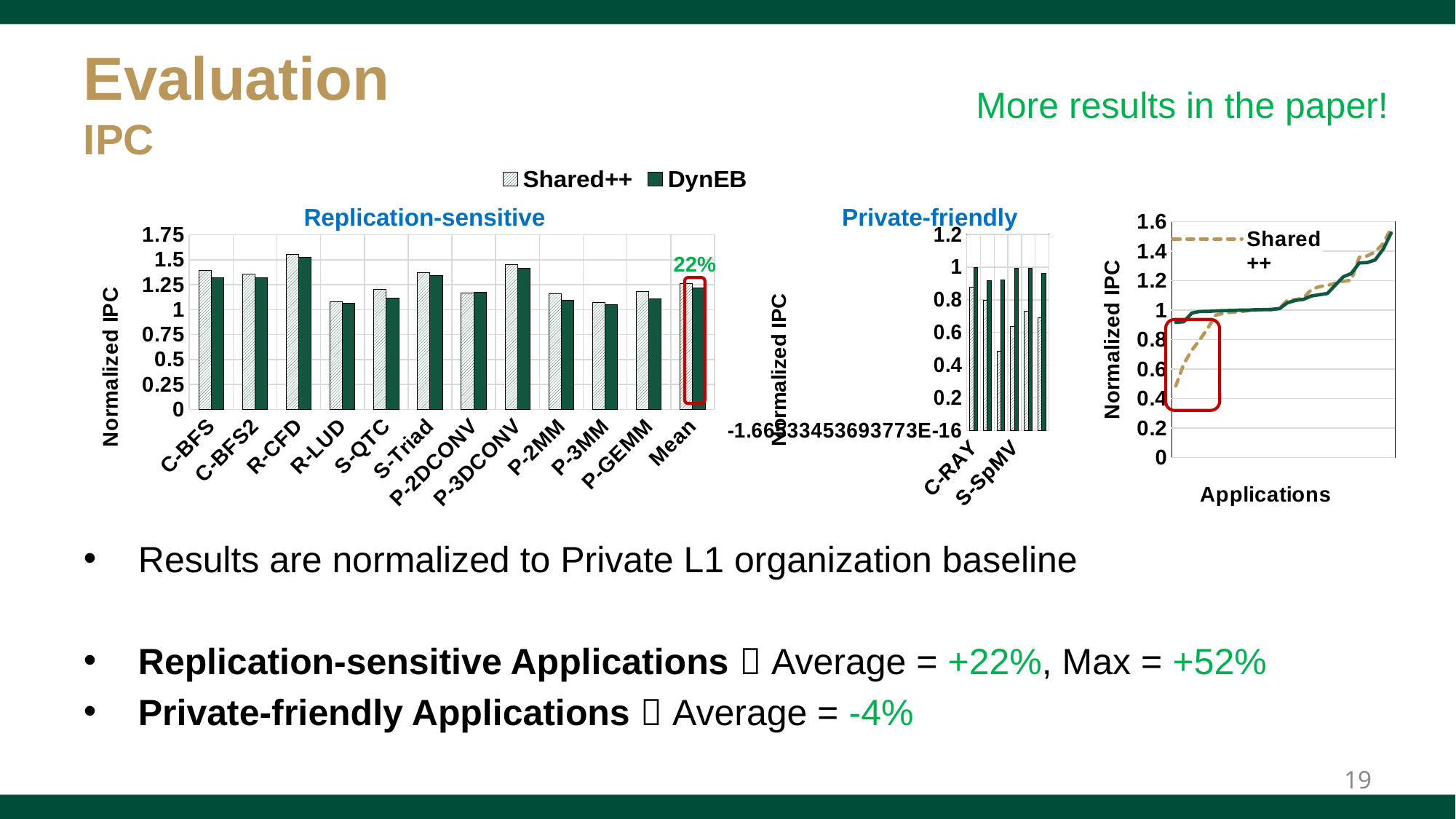
What percentage label is printed above the Mean bars in the Replication-sensitive chart? 22% What kind of chart is the Replication-sensitive chart? bar chart In the Replication-sensitive chart, which category has the highest Shared++ value? R-CFD In the rightmost chart, which series is drawn with a dashed line? Shared++ What is the x-axis title of the rightmost chart? Applications What kind of chart is the rightmost chart with the x axis labelled Applications? line chart In the Replication-sensitive chart, is the Shared++ value for R-LUD greater or less than 1.25? less How many categories are shown on the x axis of the Replication-sensitive chart? 12 In the Replication-sensitive chart, is the Shared++ value for P-3DCONV greater or less than 1.25? greater In the Replication-sensitive chart, which has the larger DynEB value, C-BFS or R-LUD? C-BFS How many series does the legend above the bar charts list? 2 In the Private-friendly chart, is the DynEB value for C-RAY greater or less than 0.8? greater